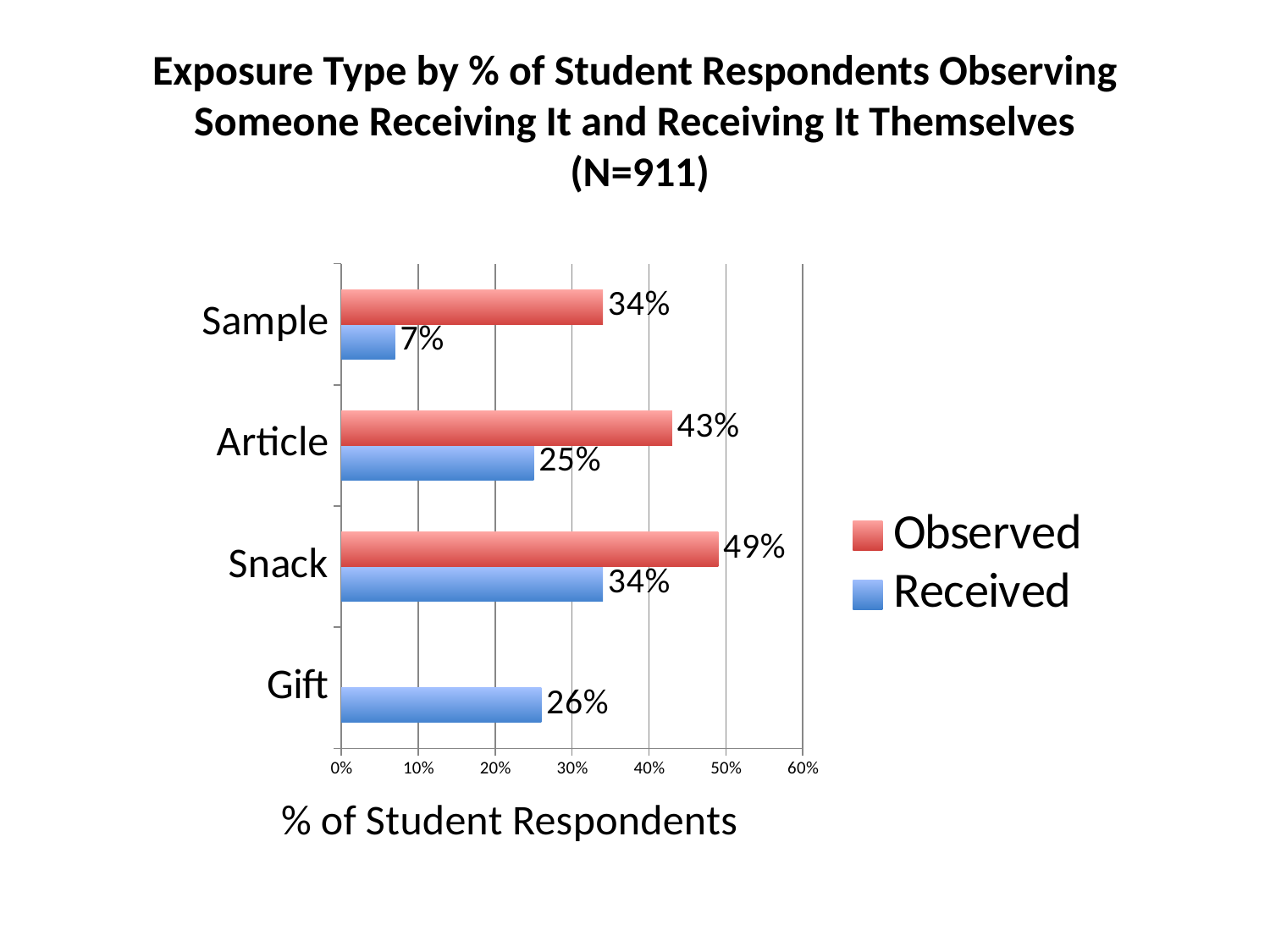
How many categories are shown on the y axis? 4 What kind of chart is shown on the slide? Bar chart Which category has the highest Observed value? Snack How many series does the legend list? 2 What is the Received value for Gift? 26% What is the difference between the Observed and Received values for Sample? 27% What is the difference between the Observed and Received values for Article? 18% What is the Observed value for Snack? 49% Which category has the lowest Received value? Sample What is the Observed value for Article? 43% What is the Received value for Sample? 7% Which is larger, the Received value for Snack or the Received value for Article? Snack